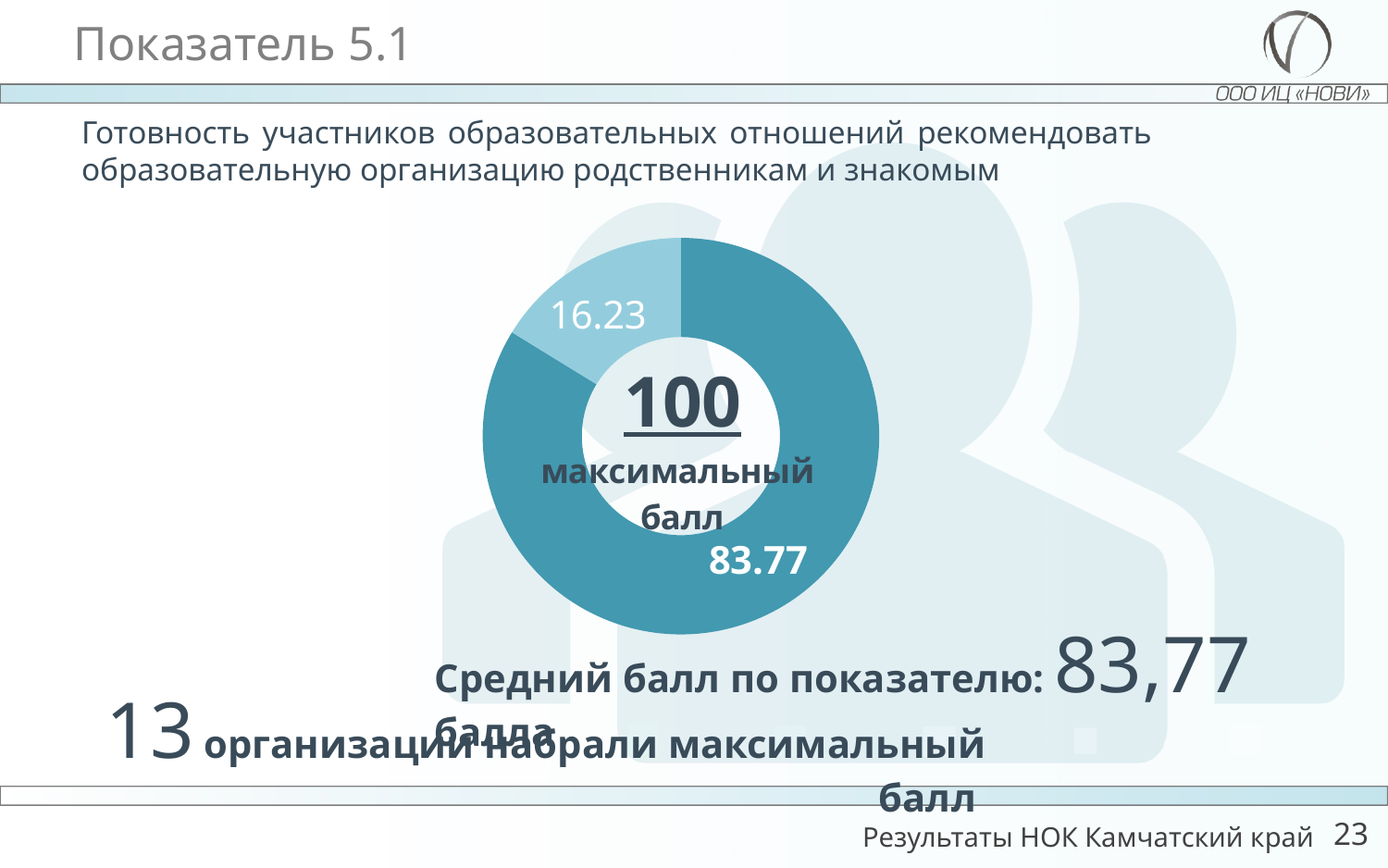
What is the difference between the two slice values on the doughnut chart (83.77 and 16.23)? 67.54 Which slice of the doughnut chart is larger, the dark teal one or the light teal one? The dark teal one (83.77) What is the total of the two slice values on the doughnut chart? 100 What value is printed on the smaller, light teal slice of the doughnut chart? 16.23 What value is printed on the larger, dark teal slice of the doughnut chart? 83.77 What is the smallest value shown on the doughnut chart? 16.23 What is the largest value shown on the doughnut chart? 83.77 What text accompanies the number in the centre of the doughnut chart? максимальный балл What share of the whole doughnut does the dark teal slice (83.77) represent? 83.77% How many slices does the doughnut chart have? 2 What number is printed in the centre of the doughnut chart? 100 What kind of chart is shown on the slide? Doughnut (pie) chart